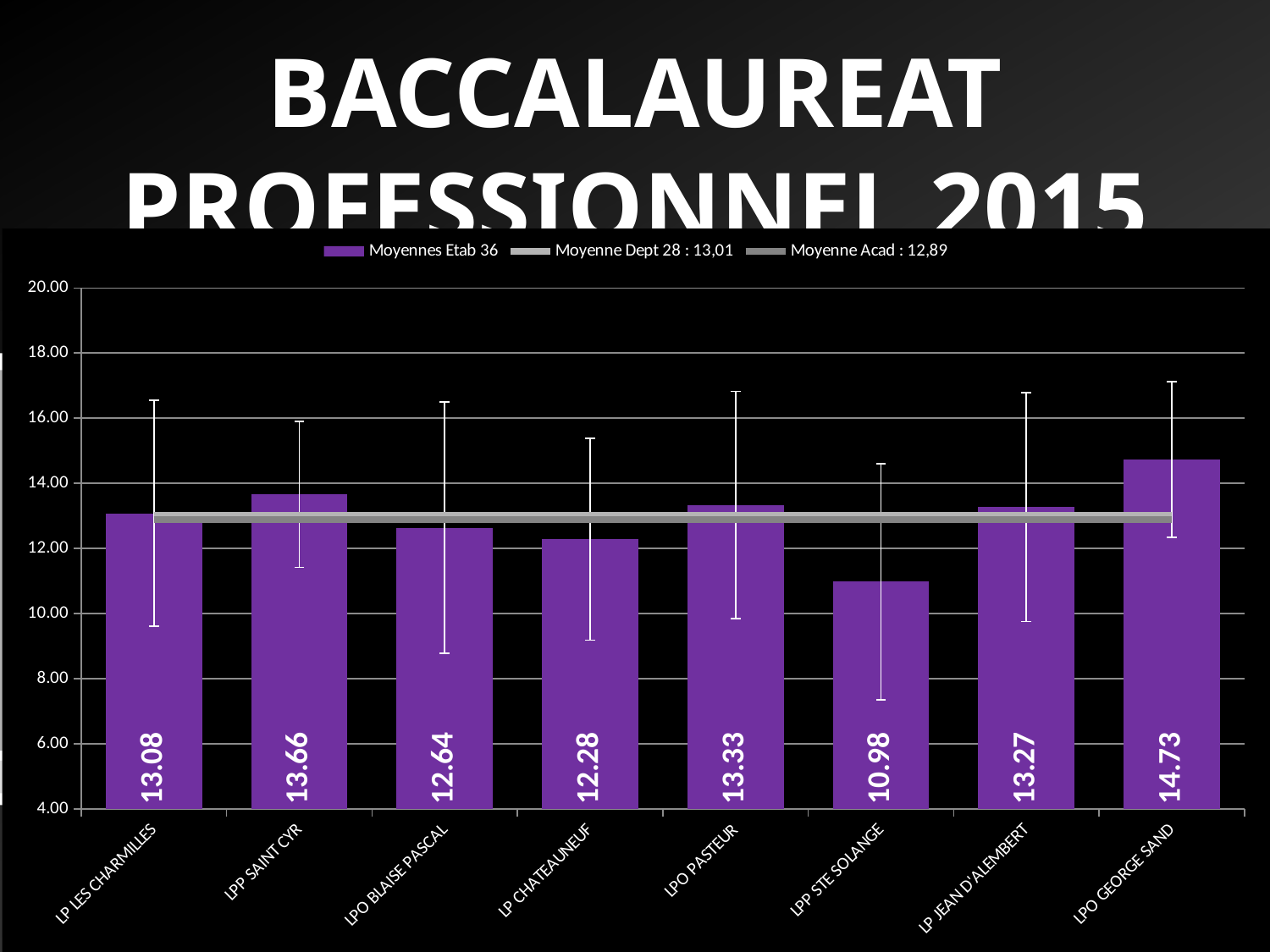
What is the value for LP JEAN D'ALEMBERT? 13.27 What is the value for LPP STE SOLANGE? 10.98 What is the value for LPP SAINT CYR? 13.66 What kind of chart is shown on the slide? bar chart Which establishment has the highest value? LPO GEORGE SAND What is the difference between the values for LPO GEORGE SAND and LPP STE SOLANGE? 3.75 Which establishment has the lowest value? LPP STE SOLANGE Is the value for LP CHATEAUNEUF greater or less than 14.00? less How many entries does the legend list? 3 Which is larger, the value for LP LES CHARMILLES or the value for LPO BLAISE PASCAL? LP LES CHARMILLES What value does the legend give for Moyenne Dept 28? 13,01 How many establishments are shown on the x axis? 8